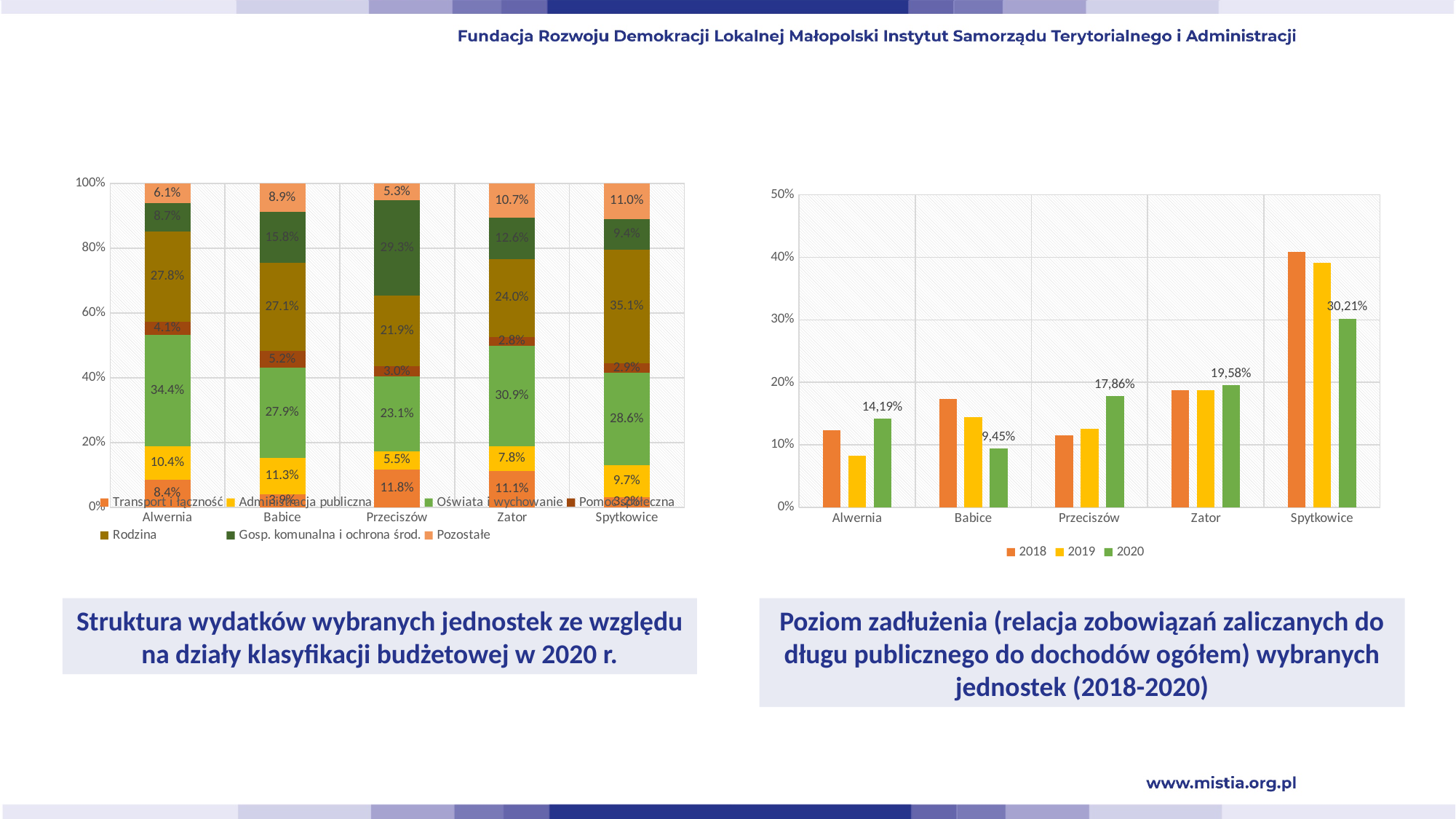
What kind of chart is the right chart (Poziom zadłużenia)? bar chart In the left chart (Struktura wydatków), which unit has the highest share for Gosp. komunalna i ochrona środ.? Przeciszów In the right chart (Poziom zadłużenia), which unit has the lowest 2020 value? Babice How many units (categories) are shown on the x axis of the left chart (Struktura wydatków)? 5 In the left chart (Struktura wydatków), which has the larger share of Oświata i wychowanie, Zator or Babice? Zator In the right chart (Poziom zadłużenia), is the 2019 value for Alwernia greater or less than 10%? less In the left chart (Struktura wydatków), what is the share of Oświata i wychowanie for Alwernia? 34.4% In the left chart (Struktura wydatków), what is the share of Rodzina for Spytkowice? 35.1% How many series does the legend of the right chart (Poziom zadłużenia) list? 3 In the right chart (Poziom zadłużenia), what is the difference between the 2020 values for Zator and Alwernia? 5,39% In the right chart (Poziom zadłużenia), what is the 2020 value for Spytkowice? 30,21% In the right chart (Poziom zadłużenia), which unit has the highest 2020 value? Spytkowice